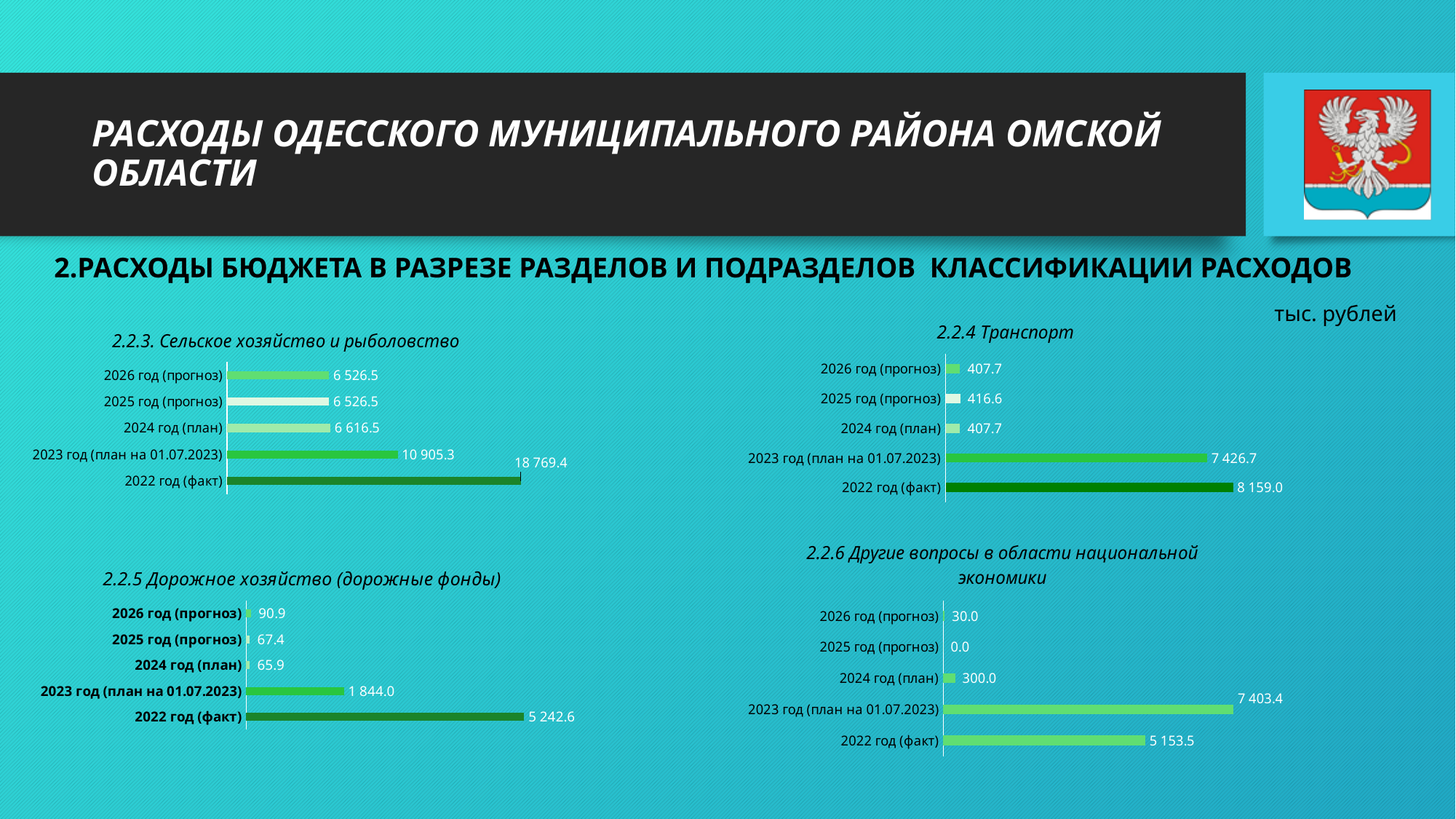
In the chart '2.2.5 Дорожное хозяйство (дорожные фонды)', which is larger: 2026 год (прогноз) or 2024 год (план)? 2026 год (прогноз) In the chart '2.2.3. Сельское хозяйство и рыболовство', which category has the lowest value? 2025 год (прогноз) and 2026 год (прогноз) (both 6 526.5) In the chart '2.2.4 Транспорт', how many categories are shown? 5 In the chart '2.2.4 Транспорт', which category has the highest value? 2022 год (факт) In the chart '2.2.5 Дорожное хозяйство (дорожные фонды)', what is the difference between 2022 год (факт) and 2023 год (план на 01.07.2023)? 3 398.6 In the chart '2.2.6 Другие вопросы в области национальной экономики', which category has the highest value? 2023 год (план на 01.07.2023) In the chart '2.2.6 Другие вопросы в области национальной экономики', what is the value for 2025 год (прогноз)? 0.0 In the chart '2.2.3. Сельское хозяйство и рыболовство', what is the value for 2022 год (факт)? 18 769.4 What type of chart is used for '2.2.4 Транспорт'? Bar chart In the chart '2.2.5 Дорожное хозяйство (дорожные фонды)', what is the value for 2023 год (план на 01.07.2023)? 1 844.0 In the chart '2.2.4 Транспорт', what is the value for 2025 год (прогноз)? 416.6 In the chart '2.2.3. Сельское хозяйство и рыболовство', what is the difference between 2022 год (факт) and 2023 год (план на 01.07.2023)? 7 864.1